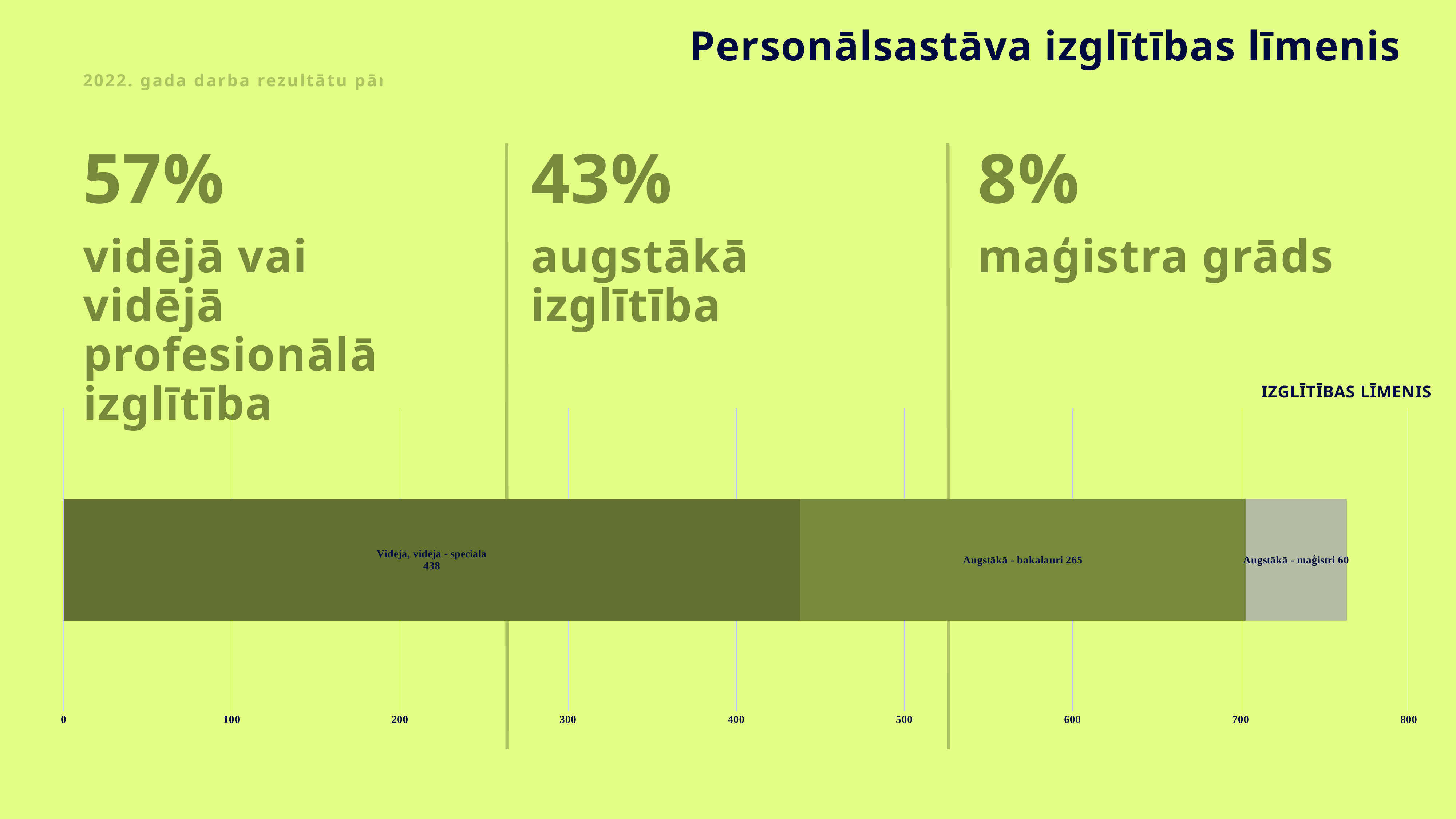
Which segment has the lowest value in the IZGLĪTĪBAS LĪMENIS chart? Augstākā - maģistri What is the value for the 'Augstākā - maģistri' segment in the IZGLĪTĪBAS LĪMENIS chart? 60 What is the total of the stacked bar in the IZGLĪTĪBAS LĪMENIS chart? 763 How many segments make up the stacked bar in the IZGLĪTĪBAS LĪMENIS chart? 3 What is the value for the 'Augstākā - bakalauri' segment in the IZGLĪTĪBAS LĪMENIS chart? 265 Which is larger in the IZGLĪTĪBAS LĪMENIS chart: 'Augstākā - bakalauri' or 'Augstākā - maģistri'? Augstākā - bakalauri What is the difference between the 'Vidējā, vidējā - speciālā' and 'Augstākā - bakalauri' values in the IZGLĪTĪBAS LĪMENIS chart? 173 What kind of chart is the IZGLĪTĪBAS LĪMENIS chart? Stacked bar chart What is the value for the 'Vidējā, vidējā - speciālā' segment in the IZGLĪTĪBAS LĪMENIS chart? 438 What is the maximum value shown on the x axis of the IZGLĪTĪBAS LĪMENIS chart? 800 Which segment has the highest value in the IZGLĪTĪBAS LĪMENIS chart? Vidējā, vidējā - speciālā What is the difference between the 'Augstākā - bakalauri' and 'Augstākā - maģistri' values in the IZGLĪTĪBAS LĪMENIS chart? 205